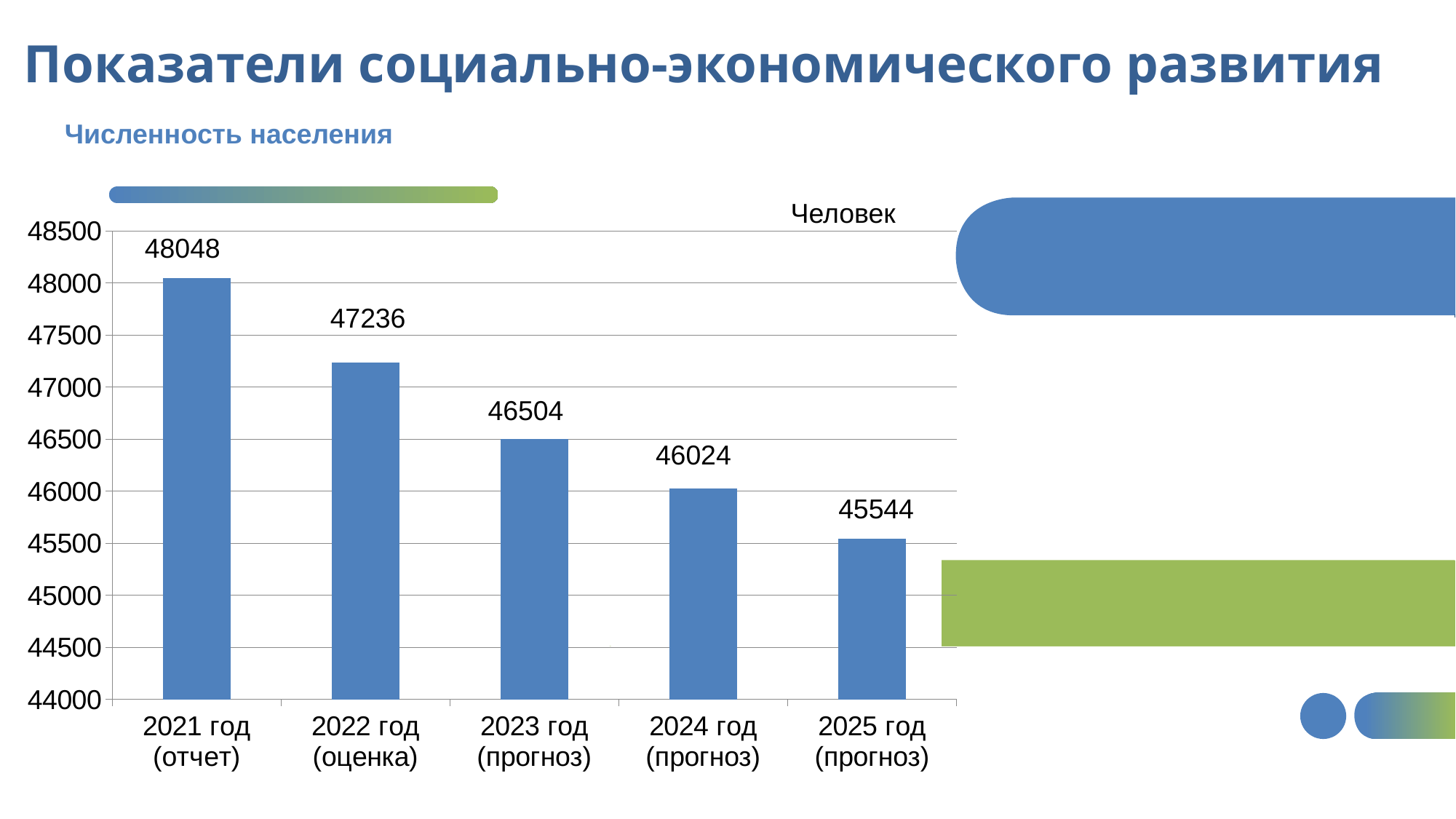
What kind of chart is used to show the population figures? bar chart How many years (bars) are shown on the chart? 5 Which year has the lowest population value on the chart? 2025 год (прогноз) Which is larger, the value for 2022 год (оценка) or the value for 2024 год (прогноз)? 2022 год (оценка) What is the difference between the values for 2021 год (отчет) and 2022 год (оценка)? 812 Do the population values rise or fall from 2021 to 2025? fall What is the value shown for 2025 год (прогноз)? 45544 Is the value for 2024 год (прогноз) greater or less than 46500? less What is the population value shown for 2021 год (отчет)? 48048 What is the difference between the values for 2021 год (отчет) and 2025 год (прогноз)? 2504 Which year has the highest population value on the chart? 2021 год (отчет) What is the value shown for 2023 год (прогноз)? 46504